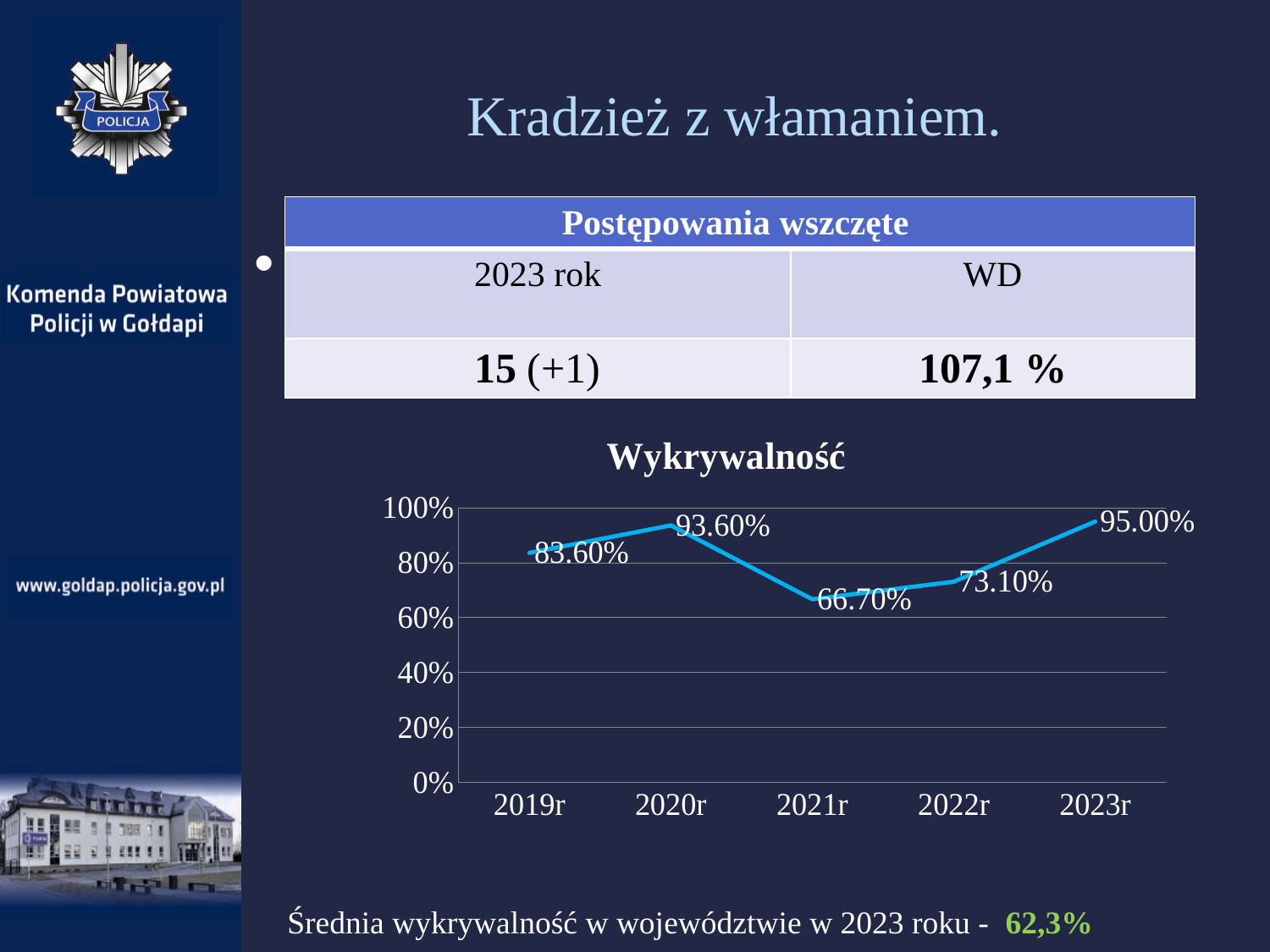
What is the difference between the values for 2023r and 2021r in the Wykrywalność chart? 28.30% What type of chart is the Wykrywalność chart? line chart Is the value for 2022r in the Wykrywalność chart greater or less than 80%? less Which year has the lowest value in the Wykrywalność chart? 2021r How many years are plotted in the Wykrywalność chart? 5 What is the value for 2019r in the Wykrywalność chart? 83.60% What is the value for 2023r in the Wykrywalność chart? 95.00% What is the difference between the values for 2020r and 2019r in the Wykrywalność chart? 10.00% Which year has the highest value in the Wykrywalność chart? 2023r What is the value for 2021r in the Wykrywalność chart? 66.70% Does the value in the Wykrywalność chart rise or fall from 2020r to 2021r? fall Which is larger in the Wykrywalność chart, the value for 2020r or the value for 2022r? 2020r